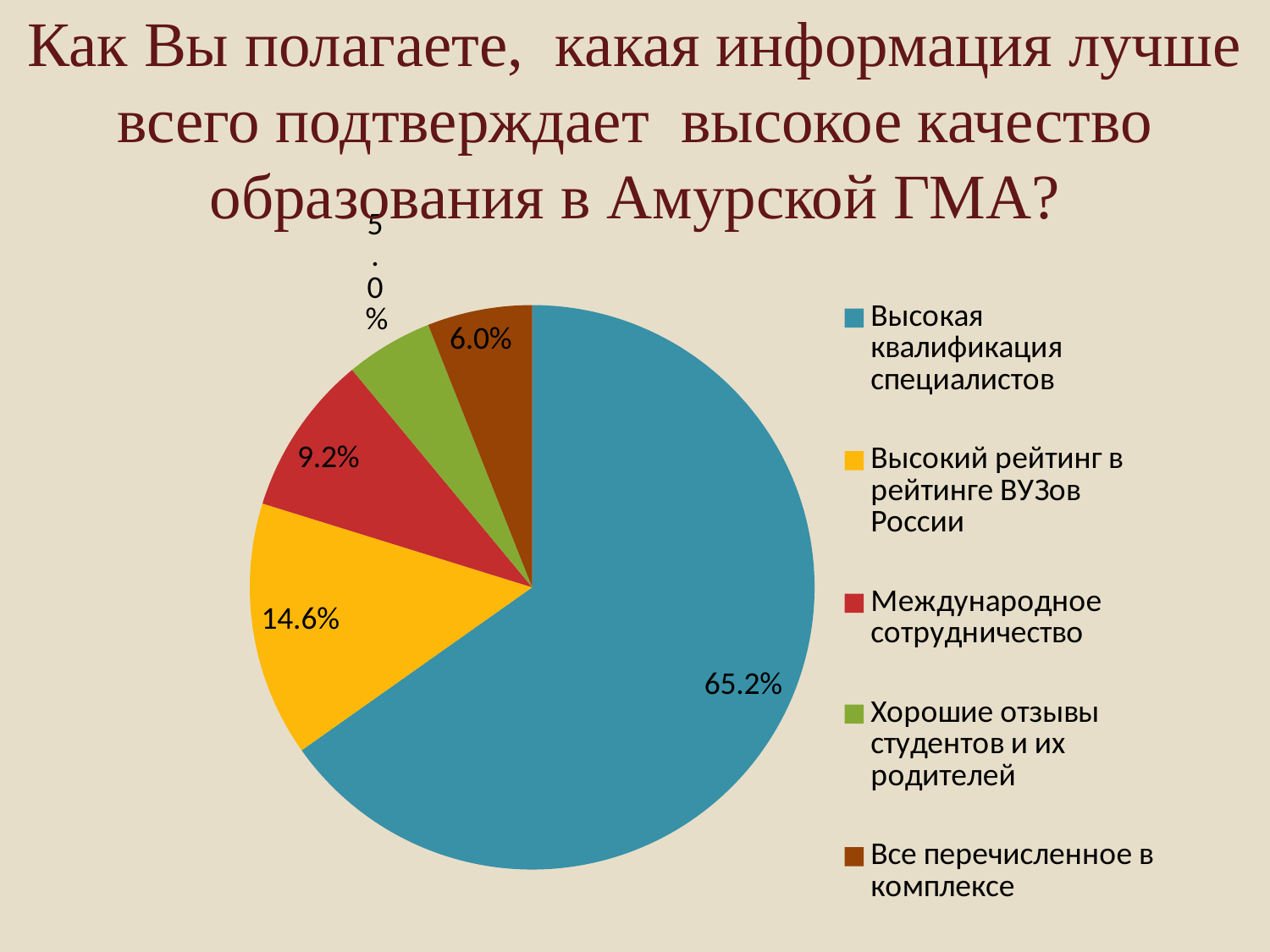
What value is shown for "Хорошие отзывы студентов и их родителей"? 5.0% What kind of chart is shown on the slide? pie chart What value is shown for "Международное сотрудничество"? 9.2% What is the difference between the values for "Высокая квалификация специалистов" and "Высокий рейтинг в рейтинге ВУЗов России"? 50.6% Which category has the smallest slice of the pie? Хорошие отзывы студентов и их родителей What value is shown for "Все перечисленное в комплексе"? 6.0% How many categories does the pie chart have? 5 What colour is the slice for "Международное сотрудничество"? red What share of the pie is labelled for "Высокая квалификация специалистов"? 65.2% Which is larger: the slice for "Международное сотрудничество" or the slice for "Все перечисленное в комплексе"? Международное сотрудничество What value is shown for "Высокий рейтинг в рейтинге ВУЗов России"? 14.6% Which category has the largest slice of the pie? Высокая квалификация специалистов